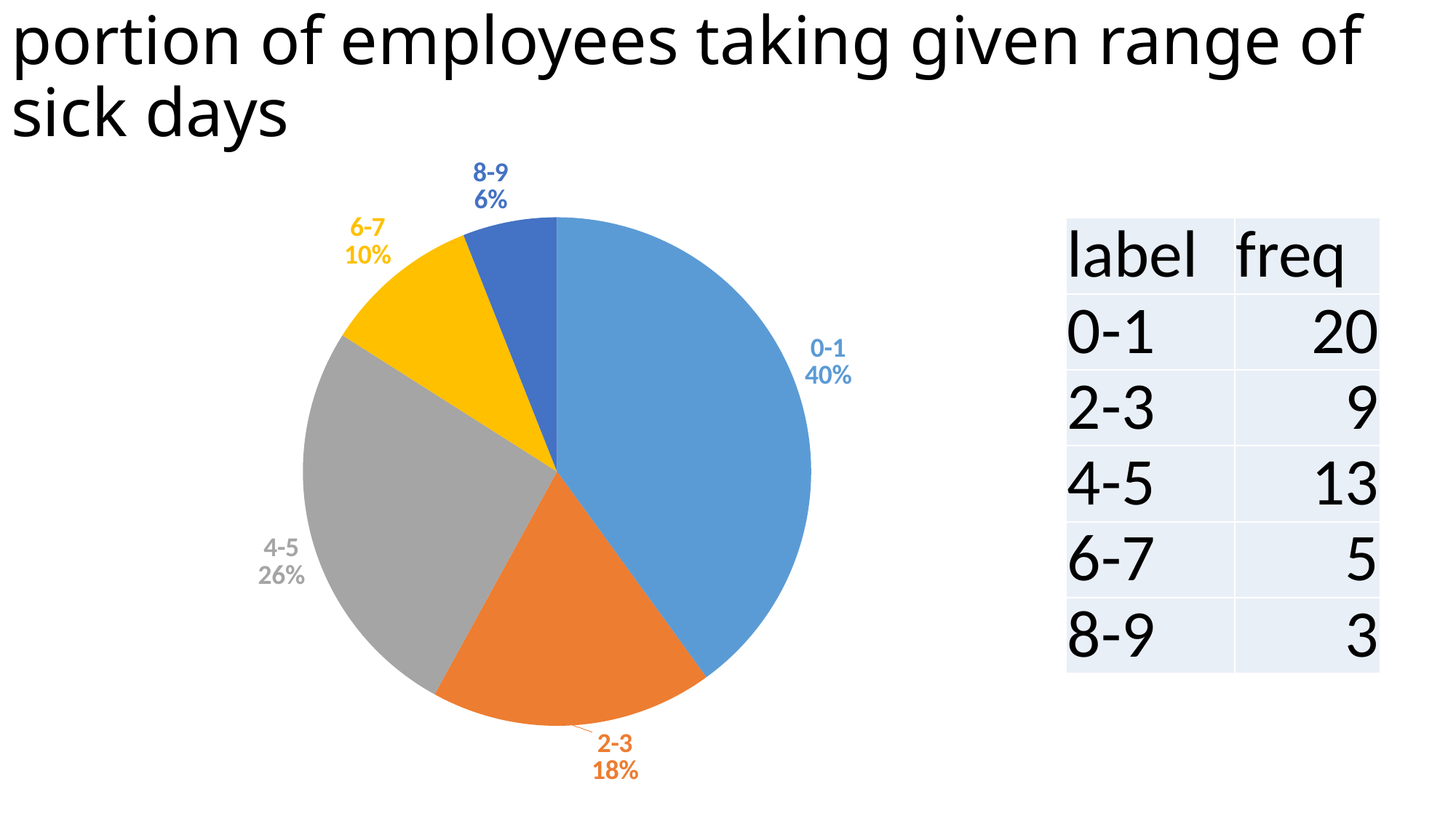
What colour is the 4-5 slice of the pie? grey What is the difference in percentage points between the 0-1 slice and the 4-5 slice? 14 What share of the pie does the 8-9 slice represent? 6% What share of the pie does the 2-3 slice represent? 18% How many slices does the pie chart have? 5 Which slice is larger, 2-3 or 6-7? 2-3 Which category has the smallest slice of the pie? 8-9 What kind of chart is shown on the slide? pie chart What share of the pie does the 6-7 slice represent? 10% Which category has the largest slice of the pie? 0-1